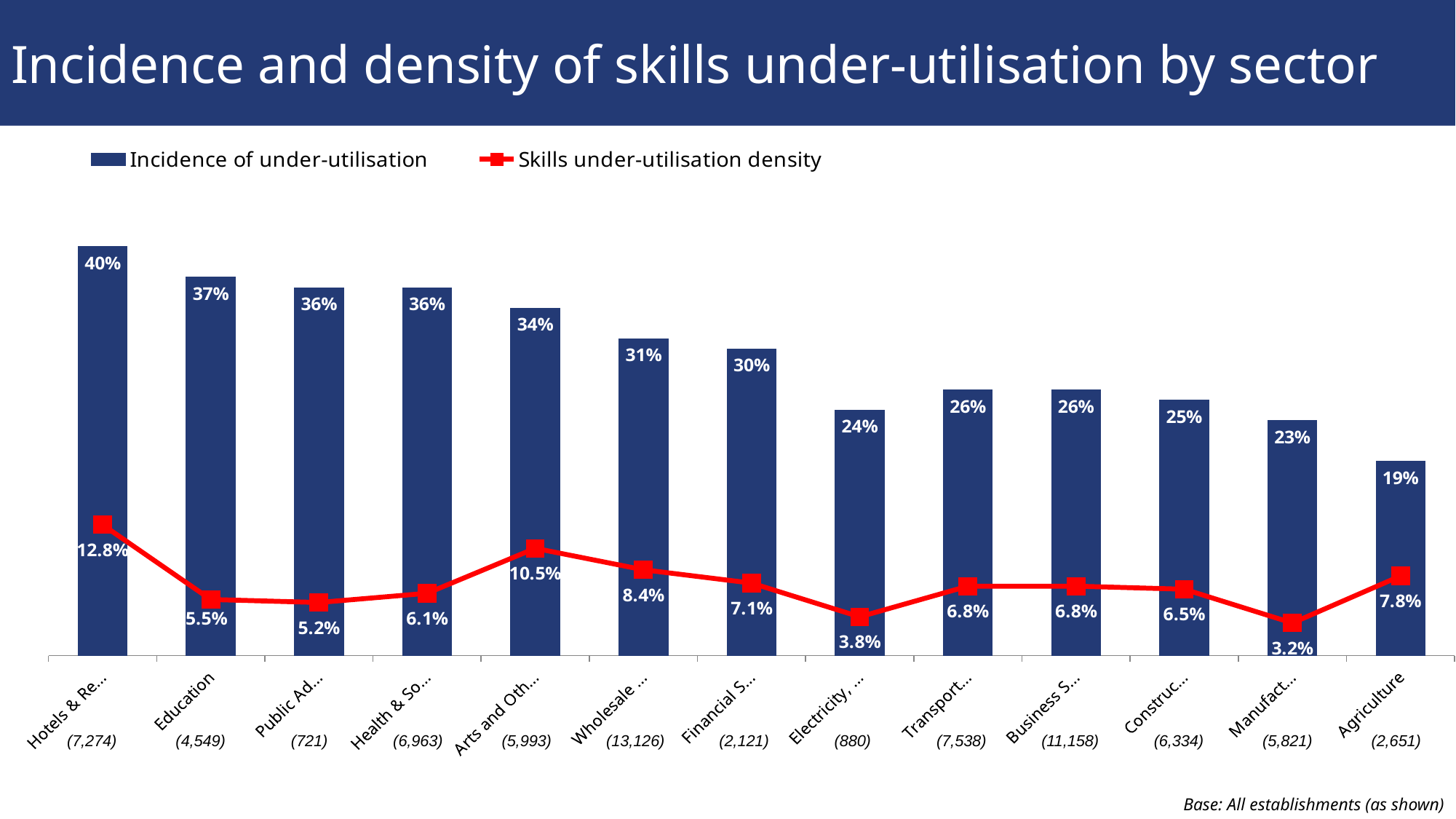
Do the Incidence of under-utilisation bars generally rise or fall from left to right? Fall What is the difference in Incidence of under-utilisation between Education and Agriculture? 18 percentage points Which sector has the lowest Incidence of under-utilisation? Agriculture How many sectors are shown on the chart? 13 What is the Incidence of under-utilisation for Agriculture? 19% What is the Skills under-utilisation density for Agriculture? 7.8% Which has the higher Skills under-utilisation density, Education or Agriculture? Agriculture What is the highest Incidence of under-utilisation value shown on the chart? 40% How many series does the legend list? 2 What is the lowest Skills under-utilisation density value shown on the chart? 3.2% What is the Skills under-utilisation density for Education? 5.5% What is the Incidence of under-utilisation for Education? 37%